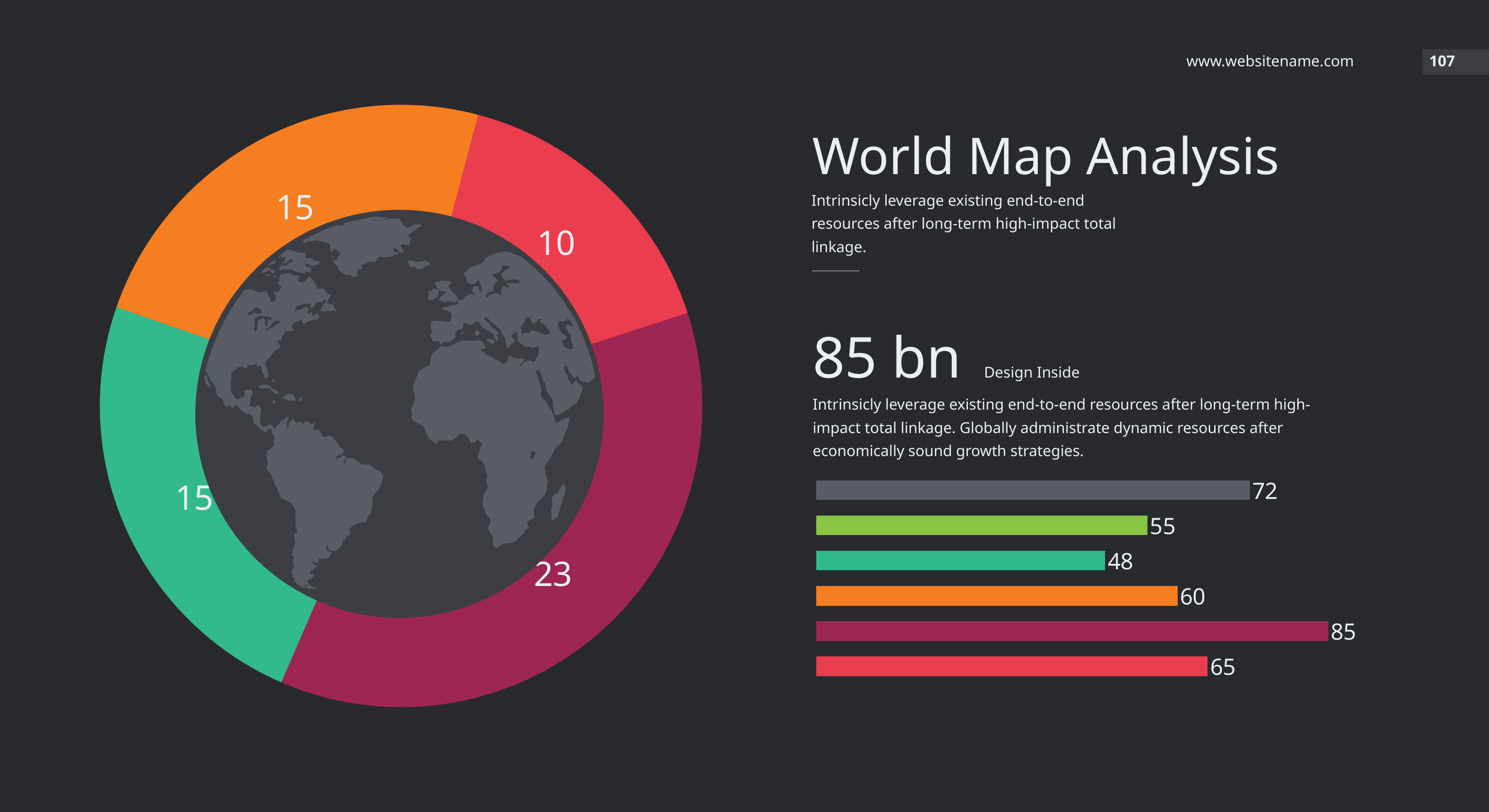
On the donut chart on the left, which segment has the largest value? The magenta segment (23) On the bar chart on the right, which is larger: the light green bar or the orange bar? The orange bar (60) On the bar chart on the right, what is the difference between the highest bar (85) and the lowest bar (48)? 37 What kind of chart is shown on the right side of the slide? Bar chart On the bar chart on the right, what is the value of the top (gray) bar? 72 On the donut chart on the left, what is the total of all four segment values? 63 On the bar chart on the right, what is the value of the bottom (red) bar? 65 On the bar chart on the right, which bar has the lowest value? The teal bar (48) On the donut chart on the left, what is the value of the red segment? 10 On the bar chart on the right, which bar has the highest value? The magenta bar (85) How many bars are shown on the bar chart on the right? 6 On the bar chart on the right, what is the value of the orange bar? 60